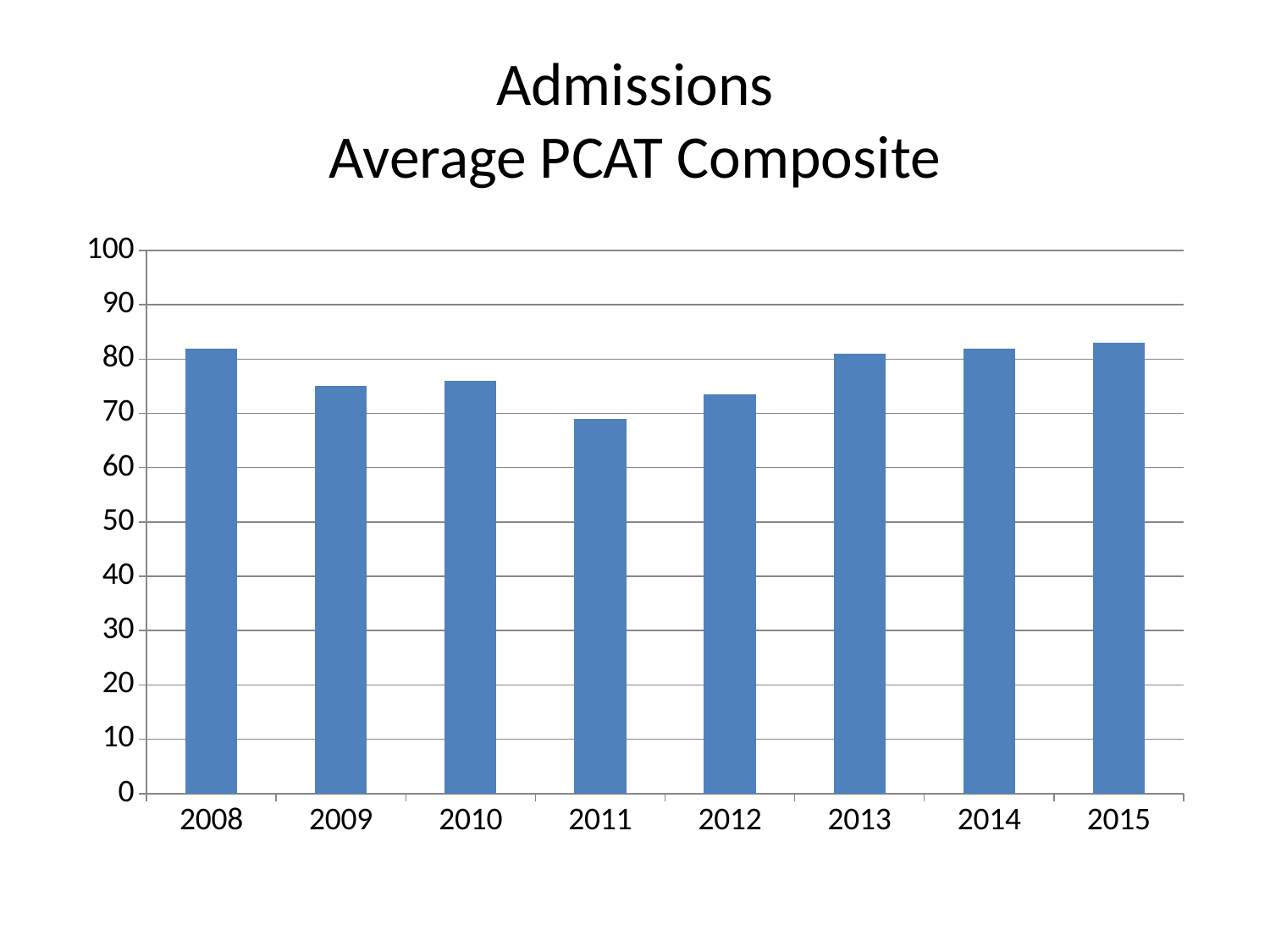
Is the value for 2011 greater or less than 70? less What kind of chart is shown on the slide? bar chart Which is larger, the value for 2011 or the value for 2013? 2013 Which is larger, the value for 2012 or the value for 2014? 2014 What is the title of the chart on the slide? Admissions Average PCAT Composite Do the values rise or fall from 2011 to 2015? rise Is the value for 2015 greater or less than 90? less Is the value for 2012 greater or less than 70? greater Which year has the lowest average PCAT composite? 2011 How many years are shown on the x axis of the chart? 8